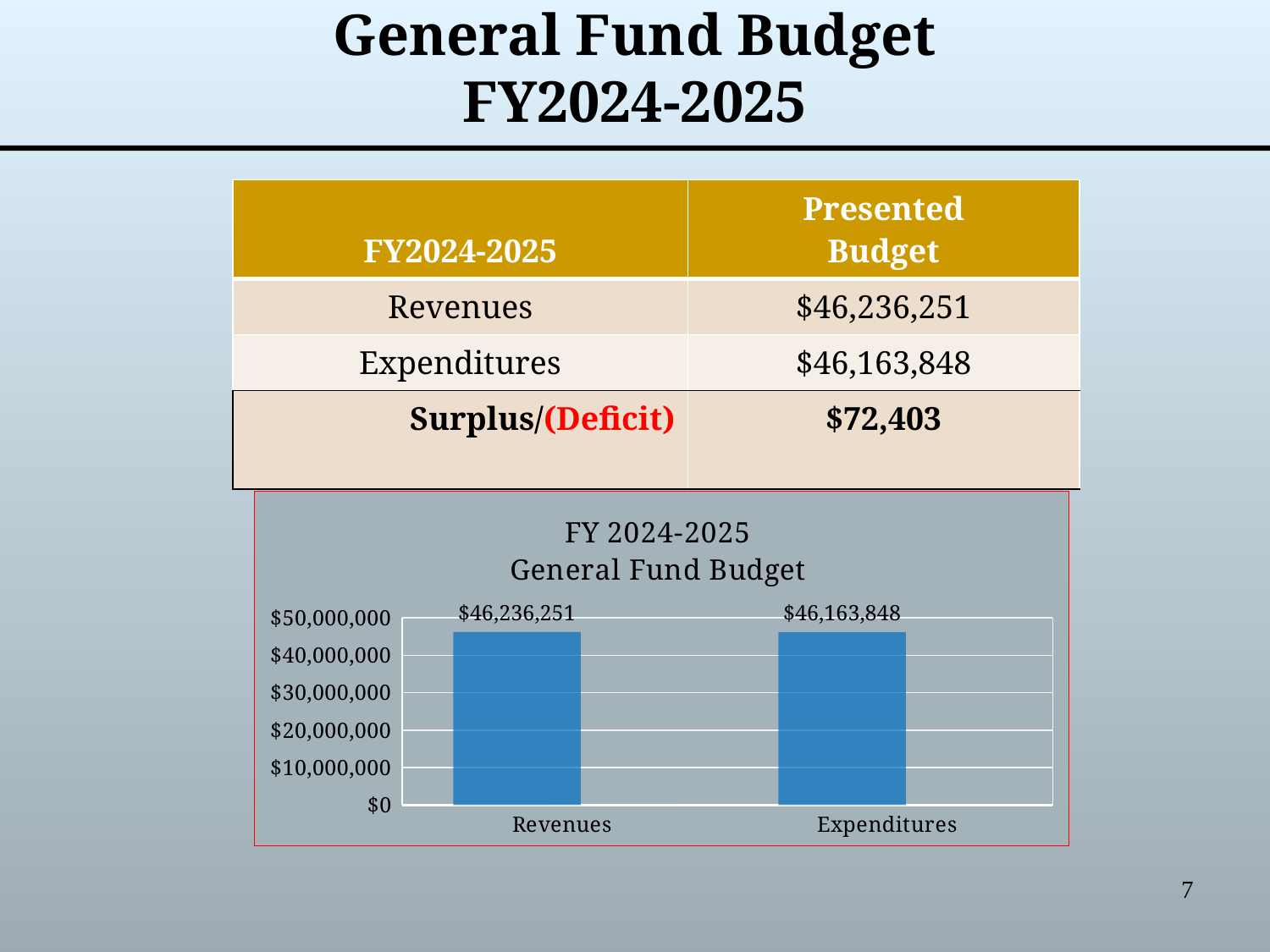
Is the value for Revenues greater or less than $40,000,000? greater What is the value of the Revenues bar in the chart? $46,236,251 Which category has the lowest value in the chart? Expenditures What is the title of the chart? FY 2024-2025 General Fund Budget What is the difference between the Revenues and Expenditures values in the chart? $72,403 What is the highest value shown on the chart's y axis? $50,000,000 How many categories are shown on the x axis of the chart? 2 Which category has the higher value in the chart, Revenues or Expenditures? Revenues What colour are the bars in the chart? blue Is the value for Expenditures greater or less than $50,000,000? less What kind of chart is shown on the slide? bar chart What is the value of the Expenditures bar in the chart? $46,163,848